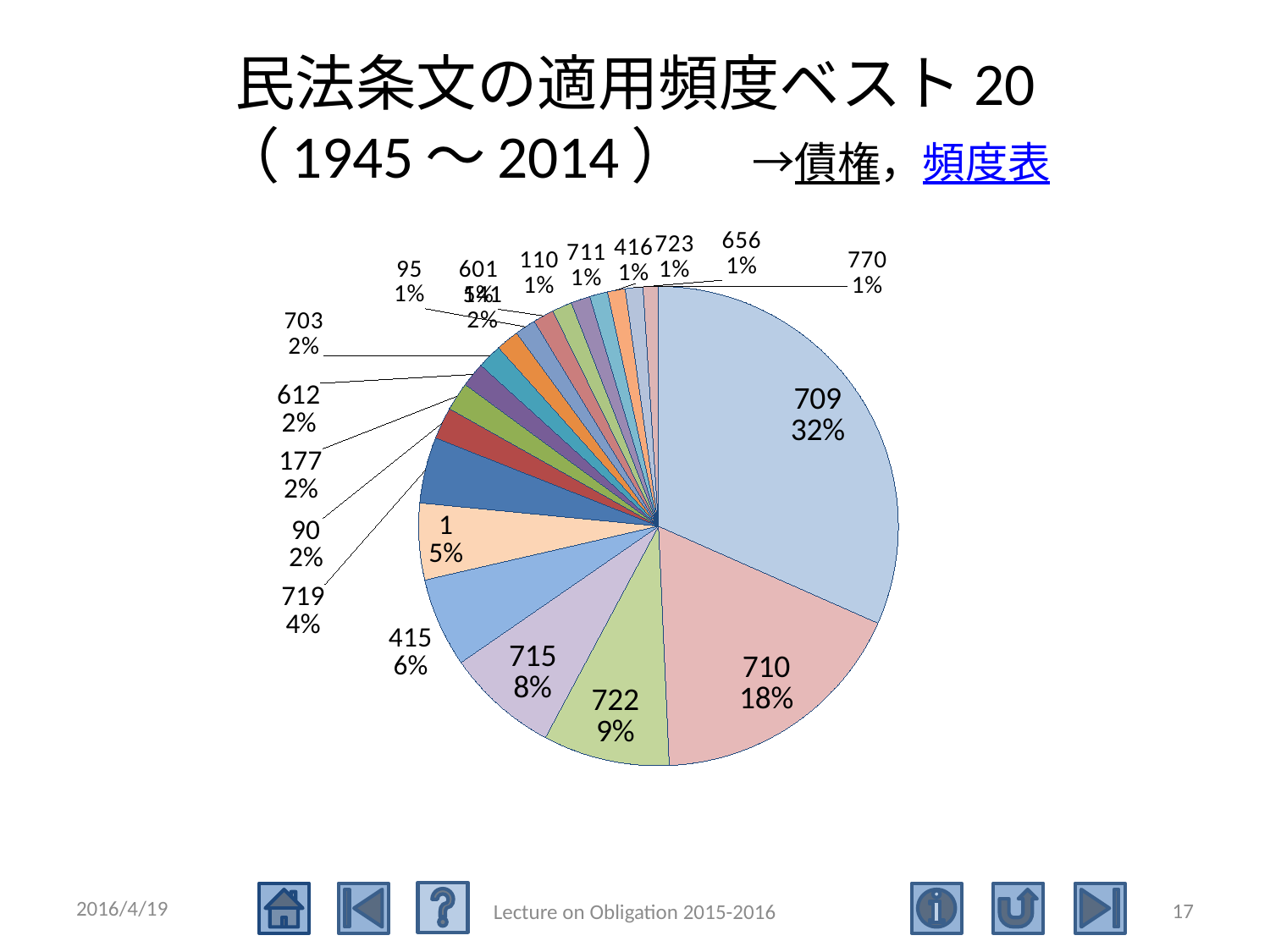
What percentage is shown for article 715? 8% What kind of chart is shown on the slide? pie chart Which has the larger share, article 722 or article 715? 722 By how many percentage points does the share of article 709 exceed that of article 710? 14 What share of the pie does article 710 account for? 18% What percentage is shown for article 1? 5% What percentage is shown for article 719? 4% Which article number has the largest slice of the pie? 709 What share of the pie does article 709 account for? 32% According to the title, how many articles are included in the chart? 20 What percentage is shown for article 722? 9% What percentage is shown for article 415? 6%